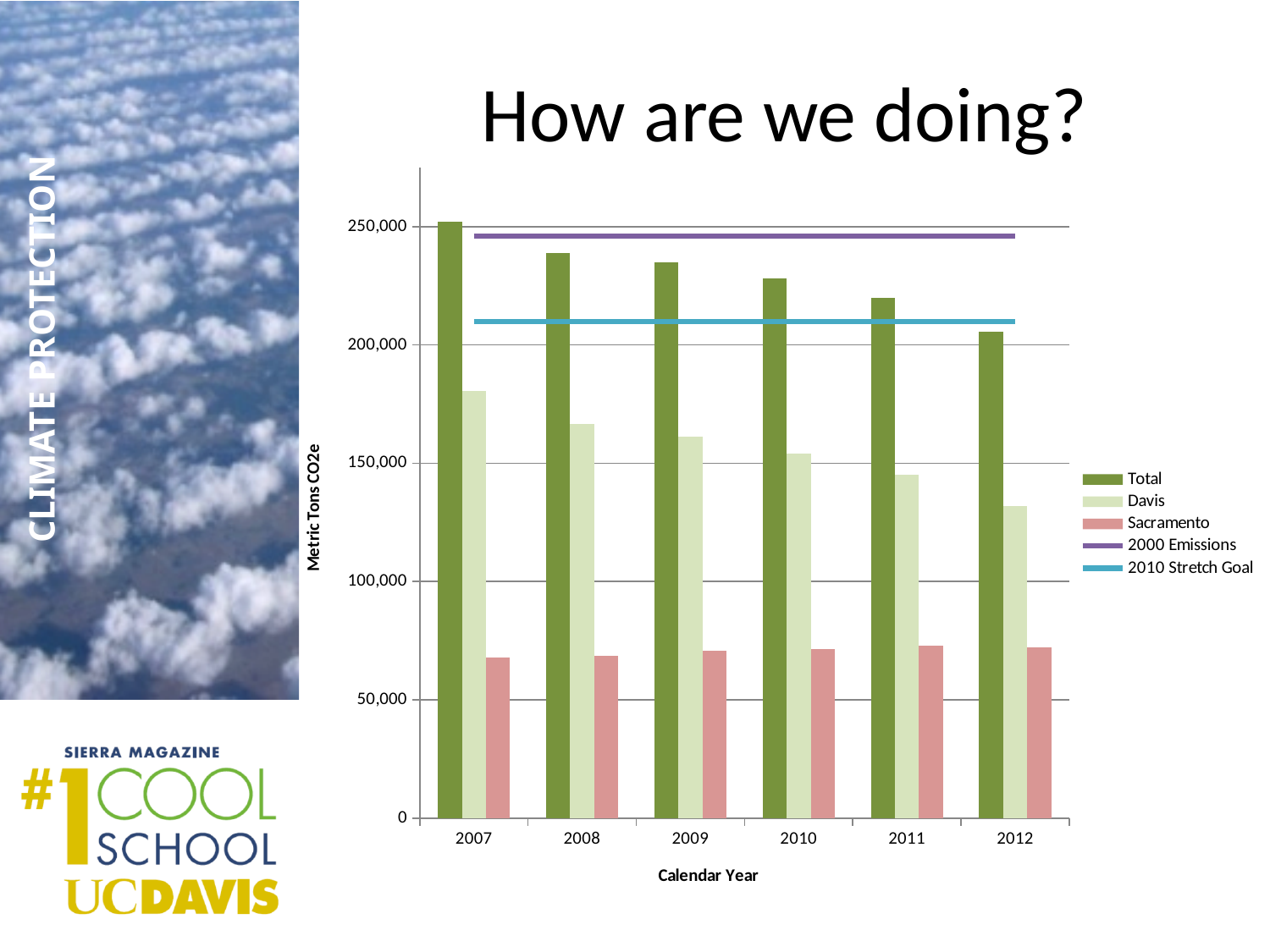
How many entries does the legend list? 5 What is the label on the y axis? Metric Tons CO2e In which year is the Total bar highest? 2007 Is the Total value for 2012 greater or less than 250,000? less Do the Total emissions rise or fall from 2007 to 2012? fall In 2009, which is larger, the Davis bar or the Sacramento bar? Davis In which year is the Total bar lowest? 2012 Is the Sacramento value for 2010 greater or less than 100,000? less What kind of chart is shown on the slide? combination bar and line chart In which year is the Davis bar lowest? 2012 How many calendar years are shown on the x axis? 6 Is the Davis value for 2007 greater or less than 150,000? greater